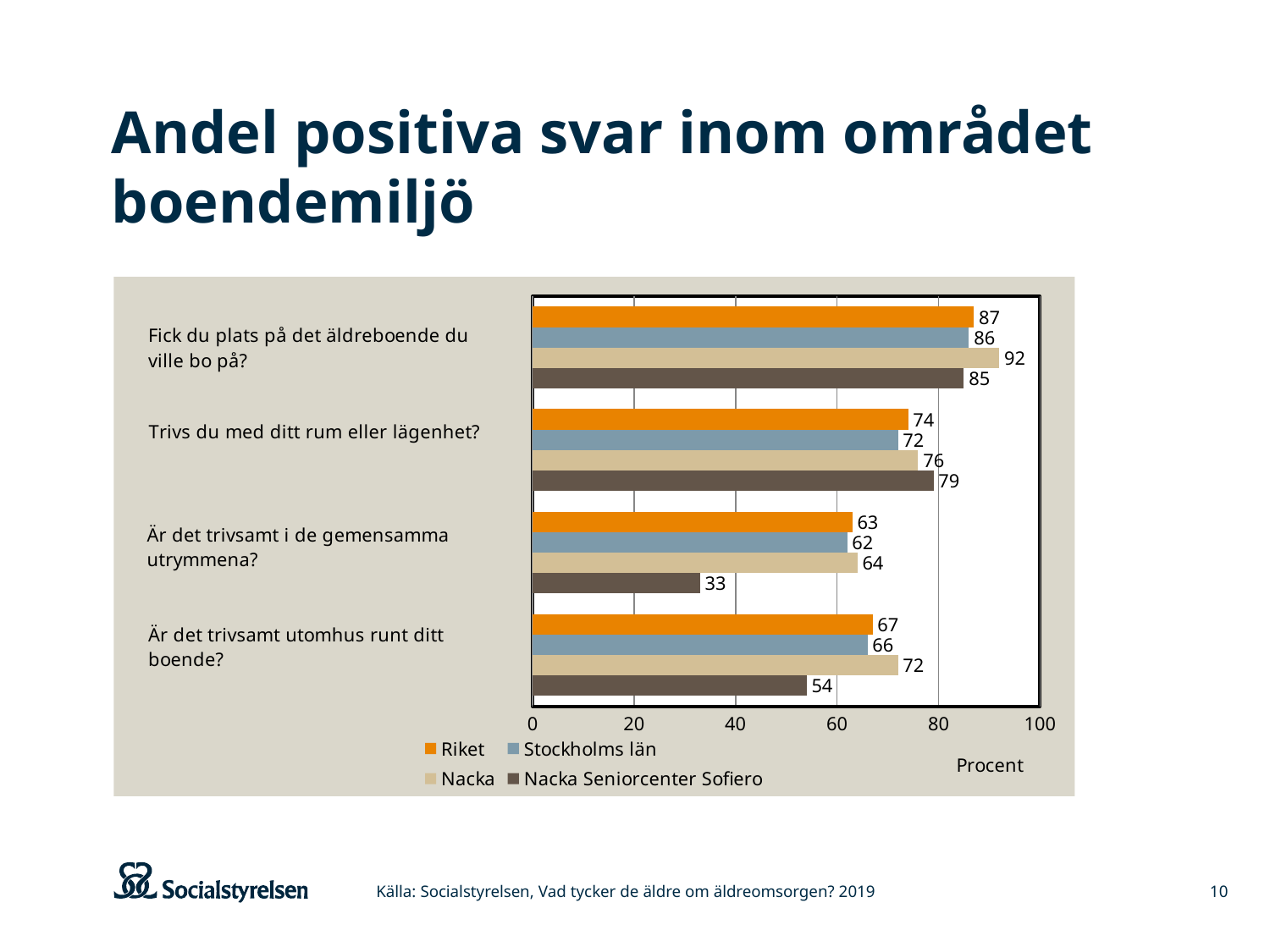
What is the label on the horizontal axis of the chart? Procent What kind of chart is shown on the slide? Bar chart How many series does the legend list? 4 Which series has the highest value on "Trivs du med ditt rum eller lägenhet?"? Nacka Seniorcenter Sofiero What is the difference between Nacka and Nacka Seniorcenter Sofiero on "Är det trivsamt i de gemensamma utrymmena?"? 31 Which is larger on "Fick du plats på det äldreboende du ville bo på?": Riket or Nacka Seniorcenter Sofiero? Riket What is the value for Riket on "Är det trivsamt utomhus runt ditt boende?"? 67 What is the value for Nacka Seniorcenter Sofiero on "Är det trivsamt i de gemensamma utrymmena?"? 33 What is the value for Stockholms län on "Trivs du med ditt rum eller lägenhet?"? 72 What is the value for Nacka on "Fick du plats på det äldreboende du ville bo på?"? 92 Which series has the lowest value on "Är det trivsamt utomhus runt ditt boende?"? Nacka Seniorcenter Sofiero How many questions (categories) are shown on the chart? 4